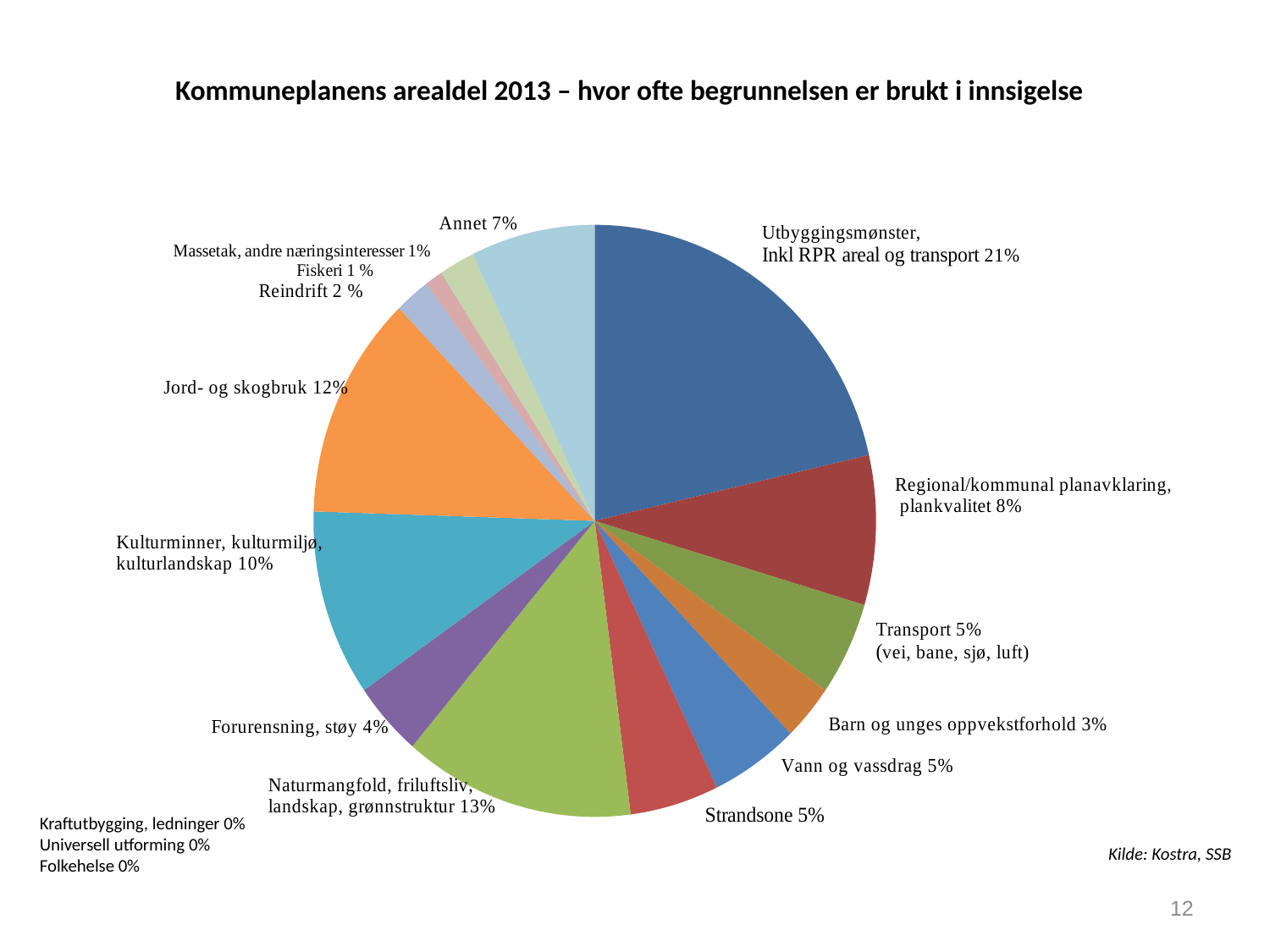
What is the value for Barn og unges oppvekstforhold? 3% What share of the pie does Utbyggingsmønster, Inkl RPR areal og transport have? 21% What is the value for Jord- og skogbruk? 12% What is the value for Kulturminner, kulturmiljø, kulturlandskap? 10% What is the title of the chart? Kommuneplanens arealdel 2013 – hvor ofte begrunnelsen er brukt i innsigelse What source is cited for the chart data? Kostra, SSB What is the value for Naturmangfold, friluftsliv, landskap, grønnstruktur? 13% Which category has the largest share of the pie? Utbyggingsmønster, Inkl RPR areal og transport What type of chart is shown on the slide? pie chart Which is larger, the share for Jord- og skogbruk or the share for Kulturminner, kulturmiljø, kulturlandskap? Jord- og skogbruk What is the value for Annet? 7% What is the difference between the shares of Utbyggingsmønster, Inkl RPR areal og transport and Regional/kommunal planavklaring, plankvalitet? 13%